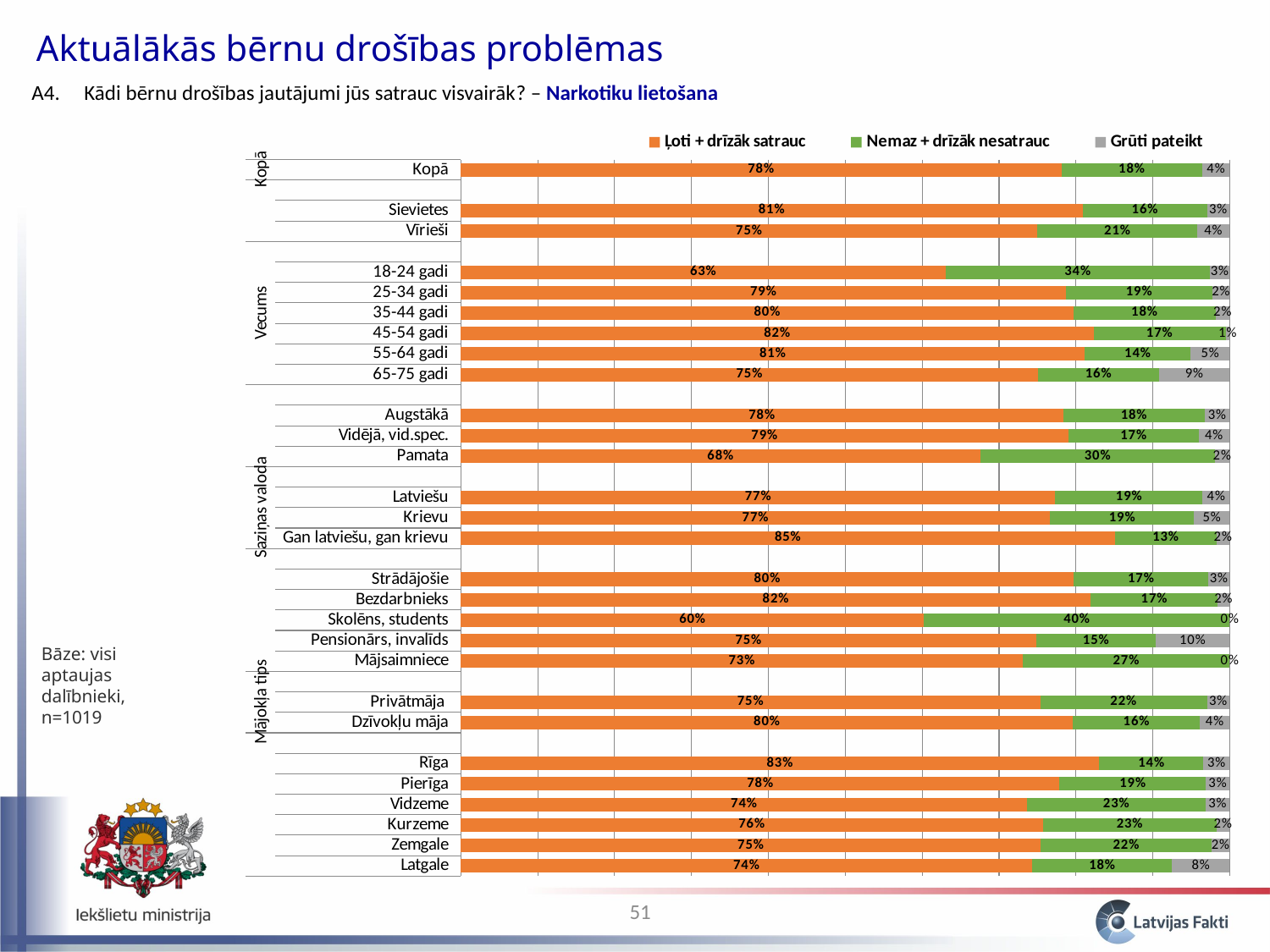
Which category has the lowest "Ļoti + drīzāk satrauc" value? Skolēns, students Which category has the highest "Nemaz + drīzāk nesatrauc" value? Skolēns, students Which has a larger "Ļoti + drīzāk satrauc" value, Rīga or Latgale? Rīga Which category has the highest "Ļoti + drīzāk satrauc" value? Gan latviešu, gan krievu What is the difference between the "Ļoti + drīzāk satrauc" values for Sievietes and Vīrieši? 6% What is the "Nemaz + drīzāk nesatrauc" value for 18-24 gadi? 34% What is the total of the stacked bar for 65-75 gadi? 100% What is the "Grūti pateikt" value for Pensionārs, invalīds? 10% Which colour represents the "Grūti pateikt" series? Grey What is the "Ļoti + drīzāk satrauc" value for Kopā? 78% How many series does the legend list? 3 What kind of chart is shown on the slide? Stacked bar chart